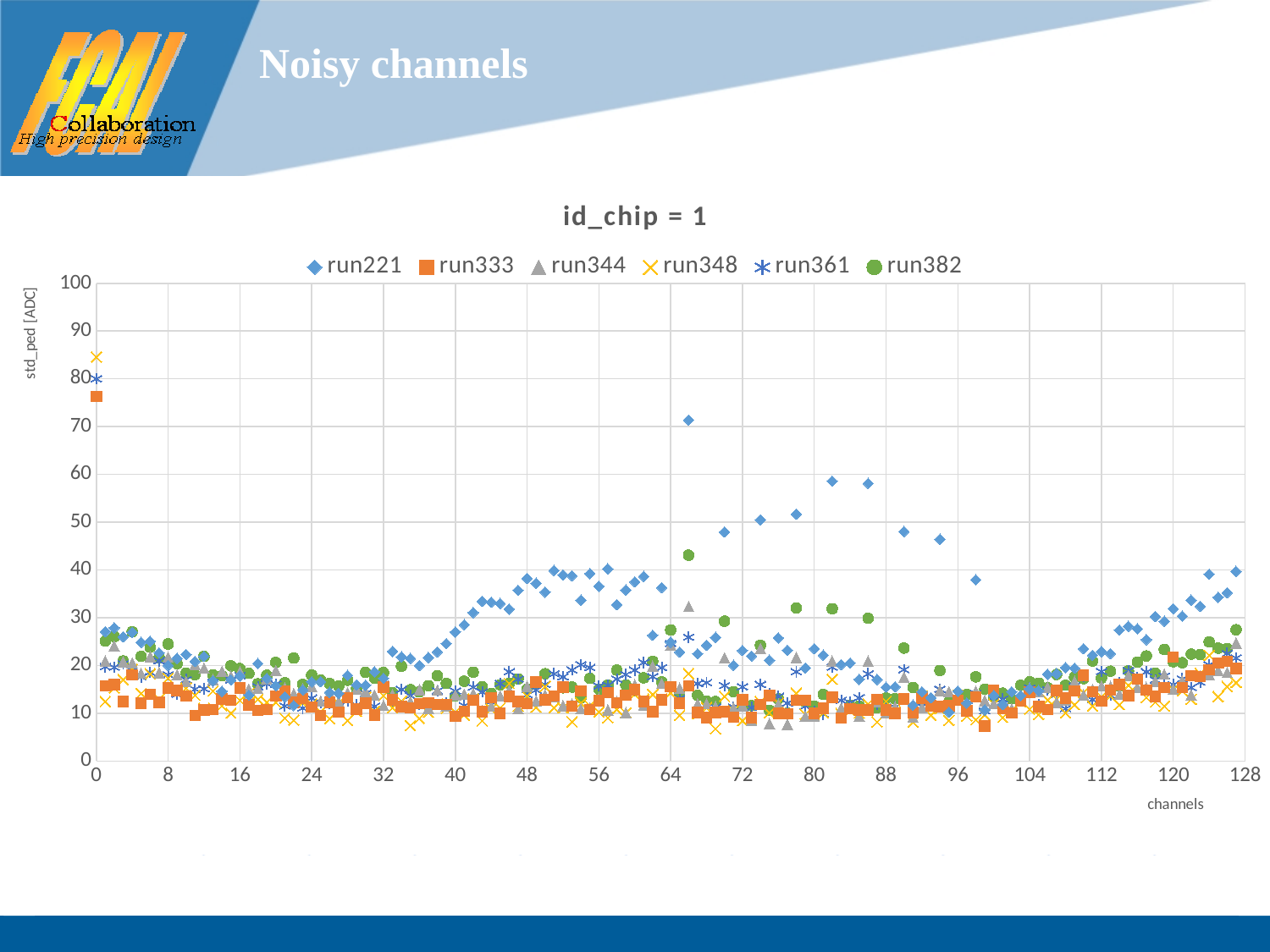
What kind of chart is shown on the slide? scatter chart What is the title of the chart? id_chip = 1 Is the value for run333 at channel 0 greater or less than 80? less Is the value for run382 at channel 66 greater or less than 40? greater Which series reaches the highest value between channels 56 and 96? run221 What is the highest tick value shown on the horizontal axis? 128 How many series does the legend list? 6 Is the value for run348 at channel 0 greater or less than 80? greater What is the label of the vertical axis? std_ped [ADC] At channel 66, which series has the larger value, run221 or run382? run221